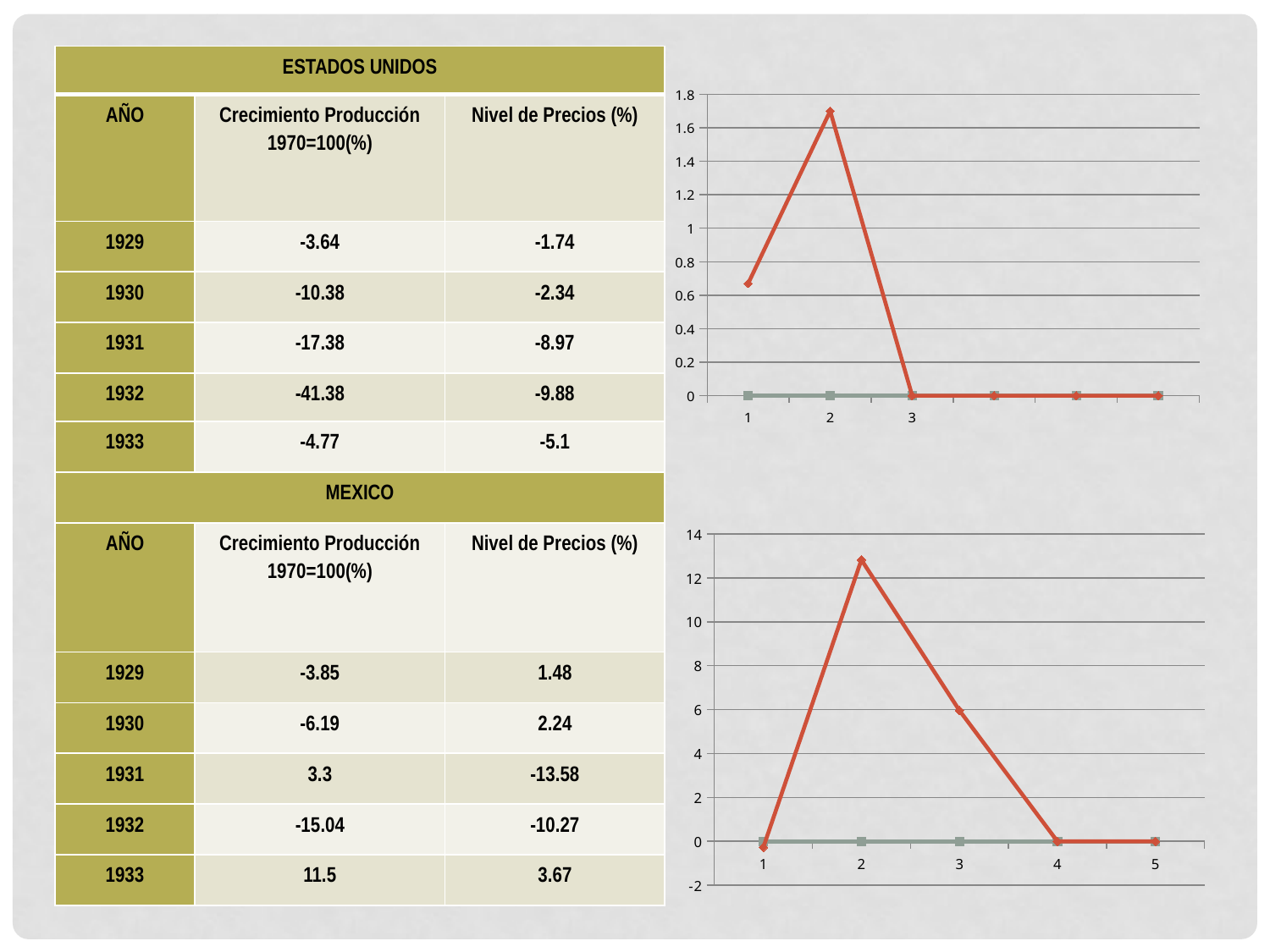
In the bottom chart, which has the larger red-line value, category 2 or category 3? 2 In the top chart, is the red line's value at category 2 greater or less than 1.6? greater In the bottom chart, is the red line's value at category 3 greater or less than 8? less In the top chart, at which x-axis category does the red line reach its highest value? 2 How many labeled categories are on the x axis of the bottom chart? 5 In the bottom chart, at which x-axis category does the red line reach its highest value? 2 What kind of chart is the bottom chart on the right of the slide? line chart What kind of chart is the top chart on the right of the slide? line chart What is the highest tick value shown on the y axis of the top chart? 1.8 In the bottom chart, does the red line rise or fall from category 2 to category 4? fall In the top chart, is the red line's value at category 1 greater or less than 0.8? less